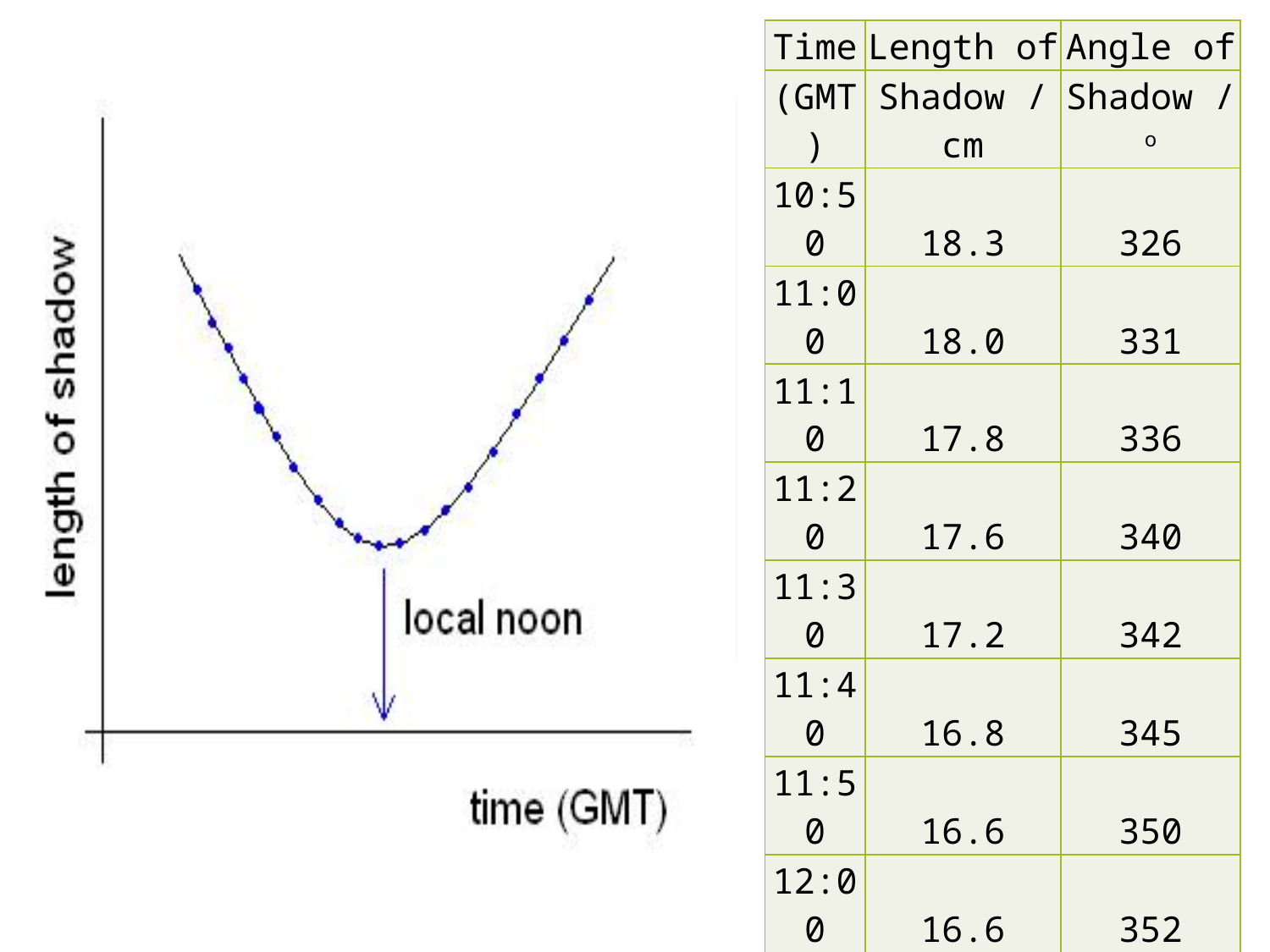
In the table, what is the angle of shadow at 12:00 GMT? 352 In the chart, what does the arrow pointing to the lowest point of the curve mark? local noon In the chart, how does the length of shadow change as time (GMT) increases? falls then rises In the table, what is the length of shadow at 11:30 GMT? 17.2 In the table, what is the difference in length of shadow between 10:50 and 12:00 GMT? 1.7 In the chart, at what time is the length of shadow at its minimum? local noon What is the label on the y axis of the chart? length of shadow What is the label on the x axis of the chart? time (GMT) In the table, does the angle of shadow rise or fall as time increases? rises What kind of chart is shown on the left of the slide? scatter plot with a fitted curve In the table, at which time is the length of shadow greatest? 10:50 How many time readings are listed in the table? 8